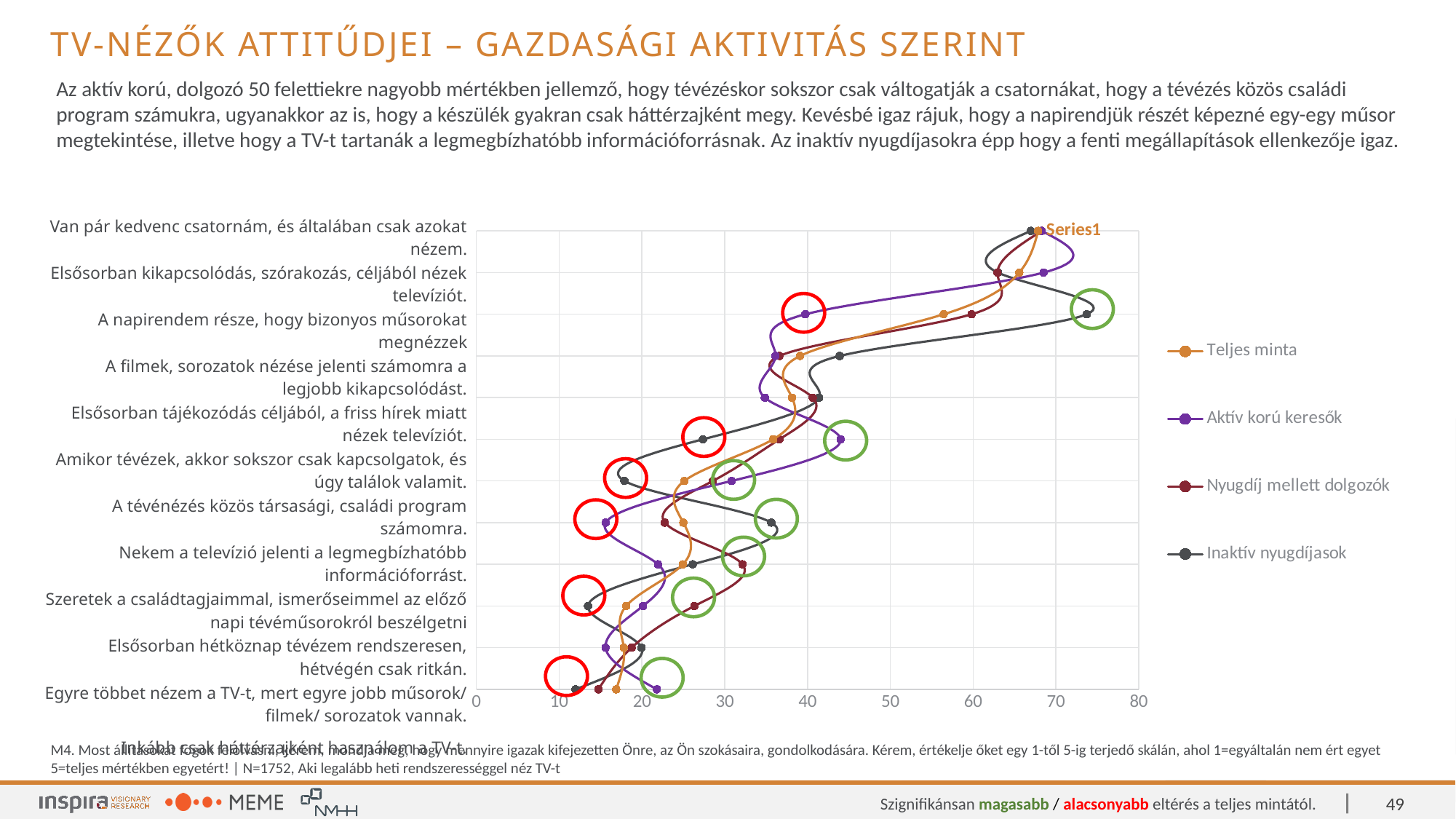
How many statements (categories) are plotted on the chart? 12 Is the 'Inaktív nyugdíjasok' value for 'Van pár kedvenc csatornám, és általában csak azokat nézem.' greater or less than 60? greater What is the maximum value shown on the horizontal axis of the chart? 80 Which colour represents the 'Aktív korú keresők' series in the legend? purple How many series does the chart legend list? 4 What is the title of the slide containing the chart? TV-NÉZŐK ATTITŰDJEI – GAZDASÁGI AKTIVITÁS SZERINT Is the 'Teljes minta' value for 'Van pár kedvenc csatornám, és általában csak azokat nézem.' greater or less than 60? greater Is the lowest value plotted for the 'Inaktív nyugdíjasok' series greater or less than 20? less What kind of chart is shown on the slide? line chart